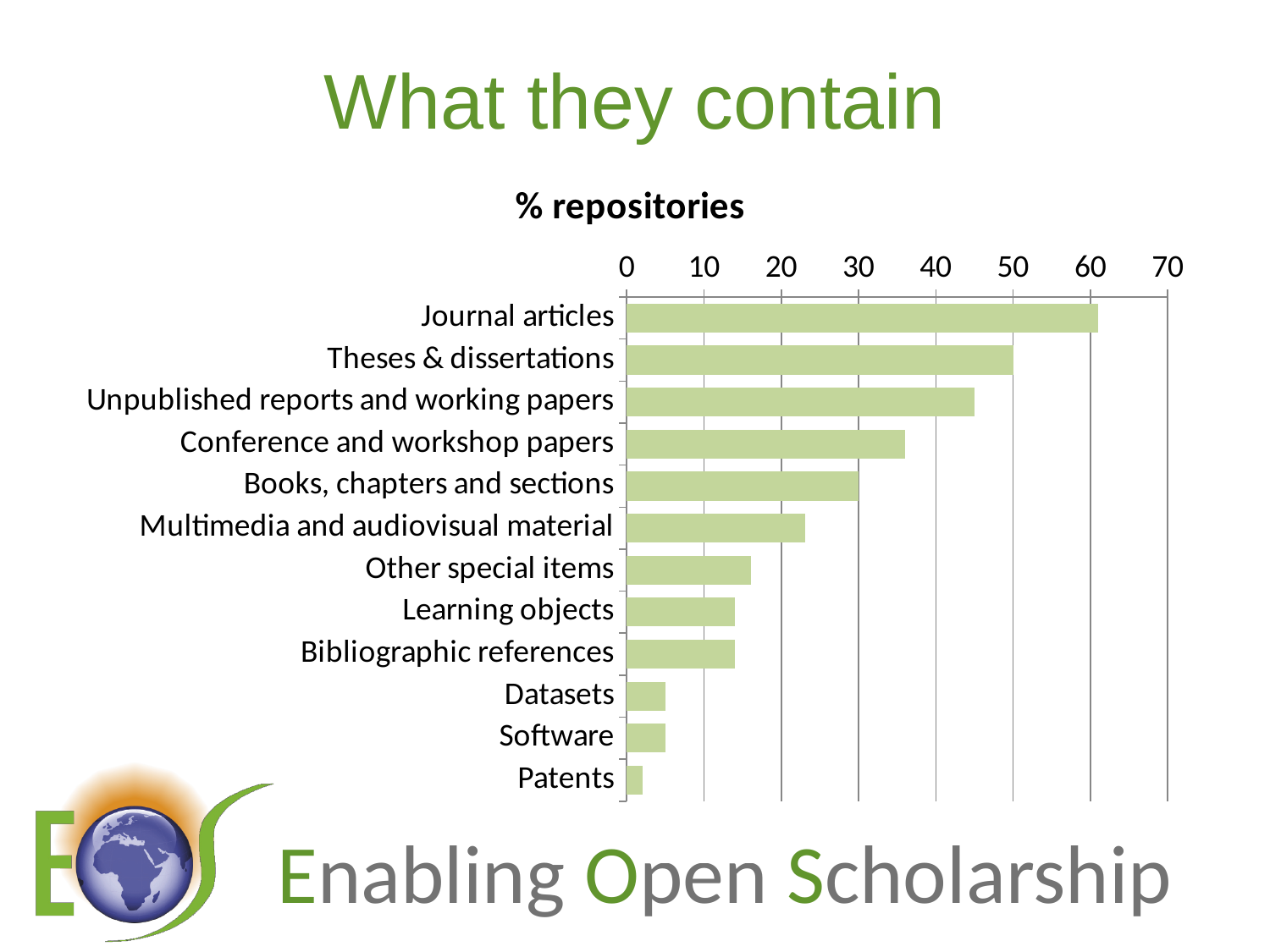
How many categories are plotted in the chart? 12 Which category has the highest value? Journal articles What is the title of the chart? % repositories Which category has the lowest value? Patents Is the value for Multimedia and audiovisual material greater or less than 20? greater What kind of chart is shown on the slide? bar chart Is the value for Conference and workshop papers greater or less than 40? less Which is larger, the value for Journal articles or the value for Theses & dissertations? Journal articles Is the value for Patents greater or less than 10? less Do the bar values increase or decrease going from the top category to the bottom category? decrease Which is larger, the value for Conference and workshop papers or the value for Multimedia and audiovisual material? Conference and workshop papers